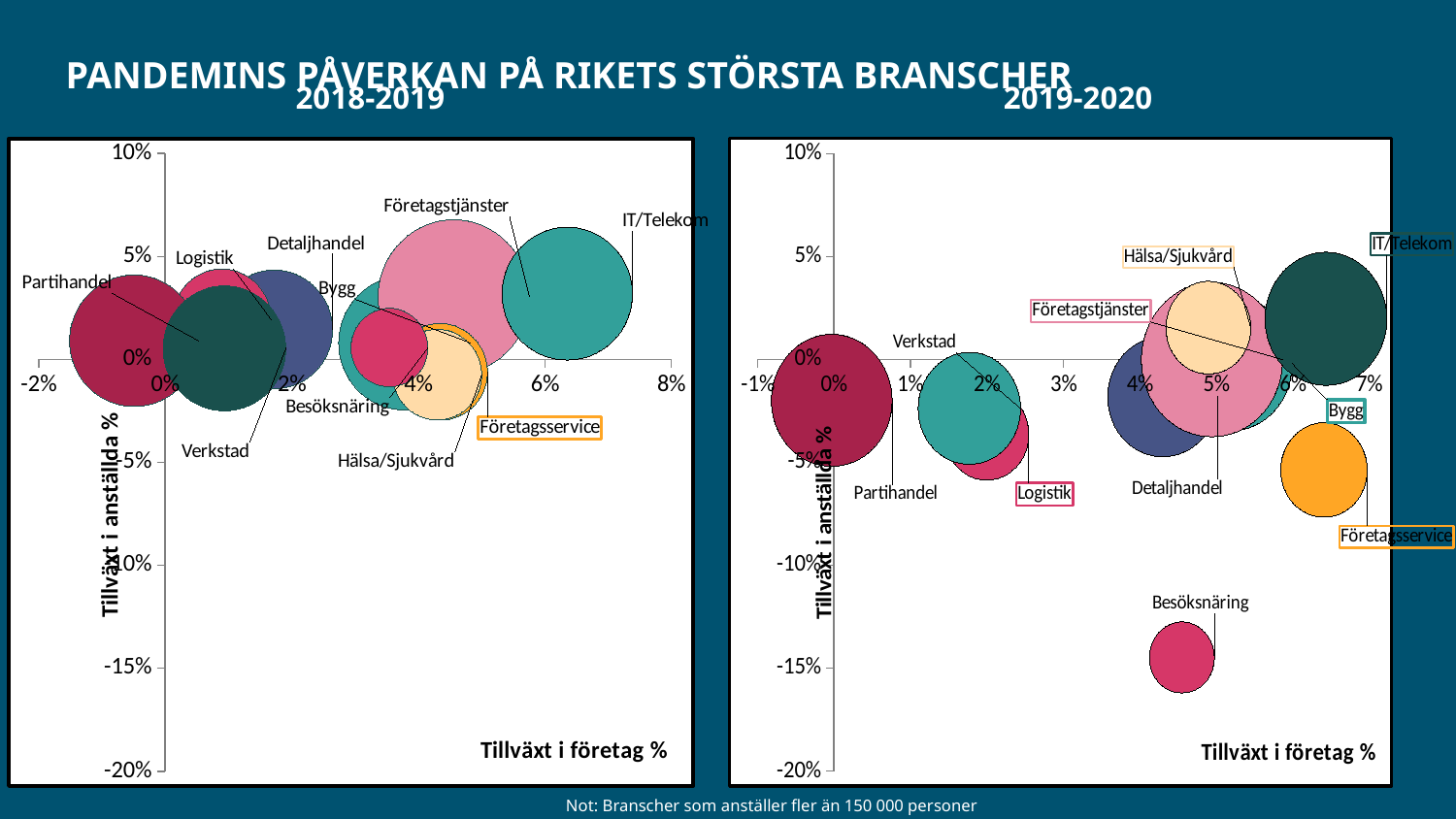
In the 2019-2020 chart, is the company growth value for IT/Telekom greater or less than 5%? greater What kind of chart is the 2018-2019 chart on the left? Bubble chart What is the lowest value shown on the y-axis of the 2019-2020 chart? -20% In the 2019-2020 chart, which has the higher company growth, IT/Telekom or Partihandel? IT/Telekom How many industries (bubbles) are plotted in the 2019-2020 chart? 10 In the 2018-2019 chart, is the company growth value for Partihandel greater or less than 2%? less In the 2019-2020 chart, which industry has the highest growth in companies (Tillväxt i företag %)? IT/Telekom In the 2019-2020 chart, which has the higher employee growth, Bygg or Besöksnäring? Bygg In the 2019-2020 chart, which industry has the lowest growth in employees (Tillväxt i anställda %)? Besöksnäring What is the x-axis title of the 2018-2019 chart? Tillväxt i företag % In the 2018-2019 chart, which industry has the highest growth in companies (Tillväxt i företag %)? IT/Telekom In the 2019-2020 chart, is the employee growth value for Besöksnäring greater or less than -10%? less